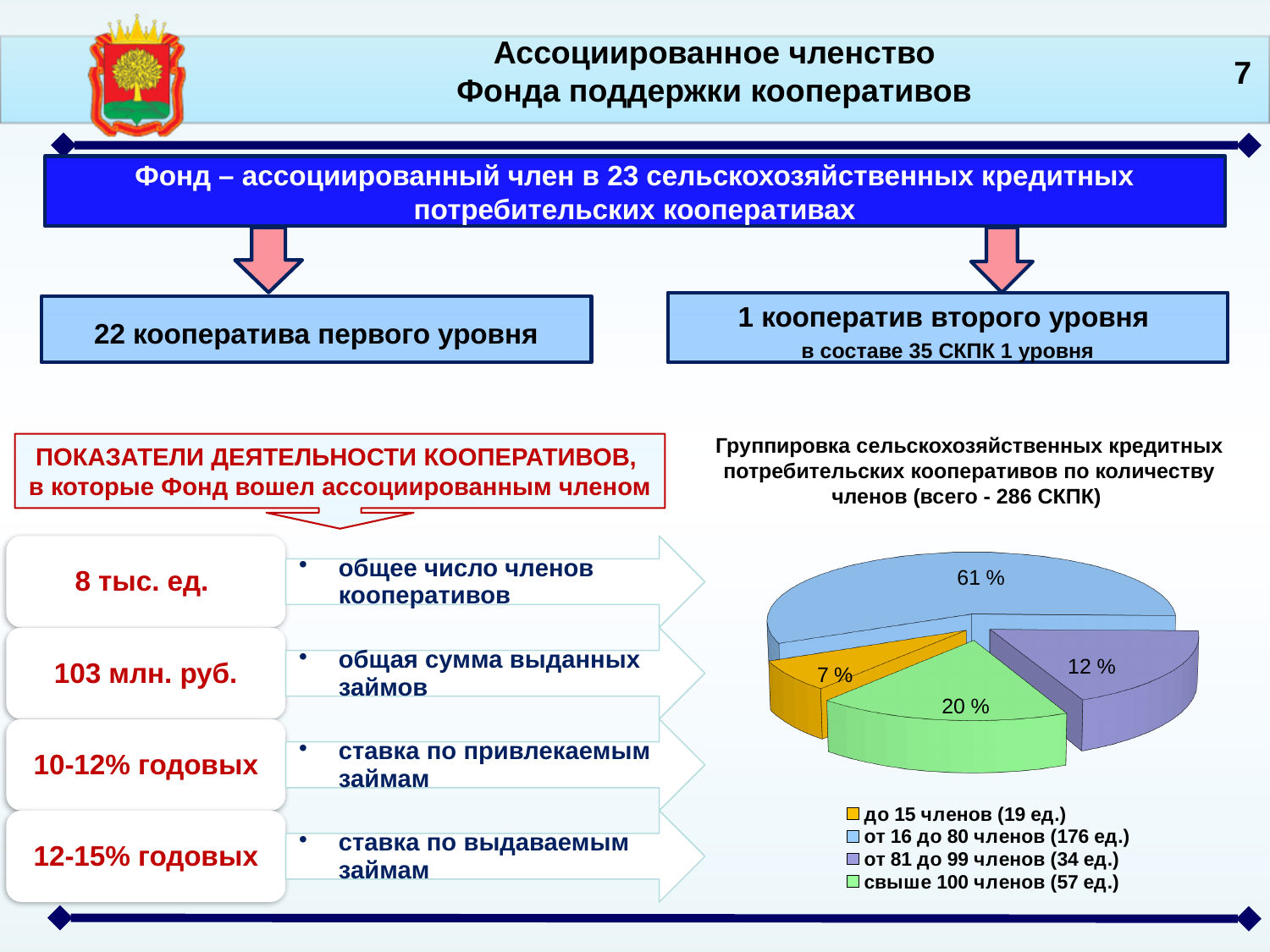
What is the title of the pie chart? Группировка сельскохозяйственных кредитных потребительских кооперативов по количеству членов (всего - 286 СКПК) What is the difference in percentage points between the 'от 16 до 80 членов' slice and the 'свыше 100 членов' slice? 41 How many entries does the legend of the pie chart list? 4 How many slices does the pie chart have? 4 What share of the pie does the category 'до 15 членов' have? 7 % What share of the pie does the category 'свыше 100 членов' have? 20 % Which slice is larger: 'от 81 до 99 членов' or 'свыше 100 членов'? свыше 100 членов What share of the pie does the category 'от 81 до 99 членов' have? 12 % Which category has the largest slice of the pie chart? от 16 до 80 членов What type of chart is shown on the slide? pie chart Which category has the smallest slice of the pie chart? до 15 членов